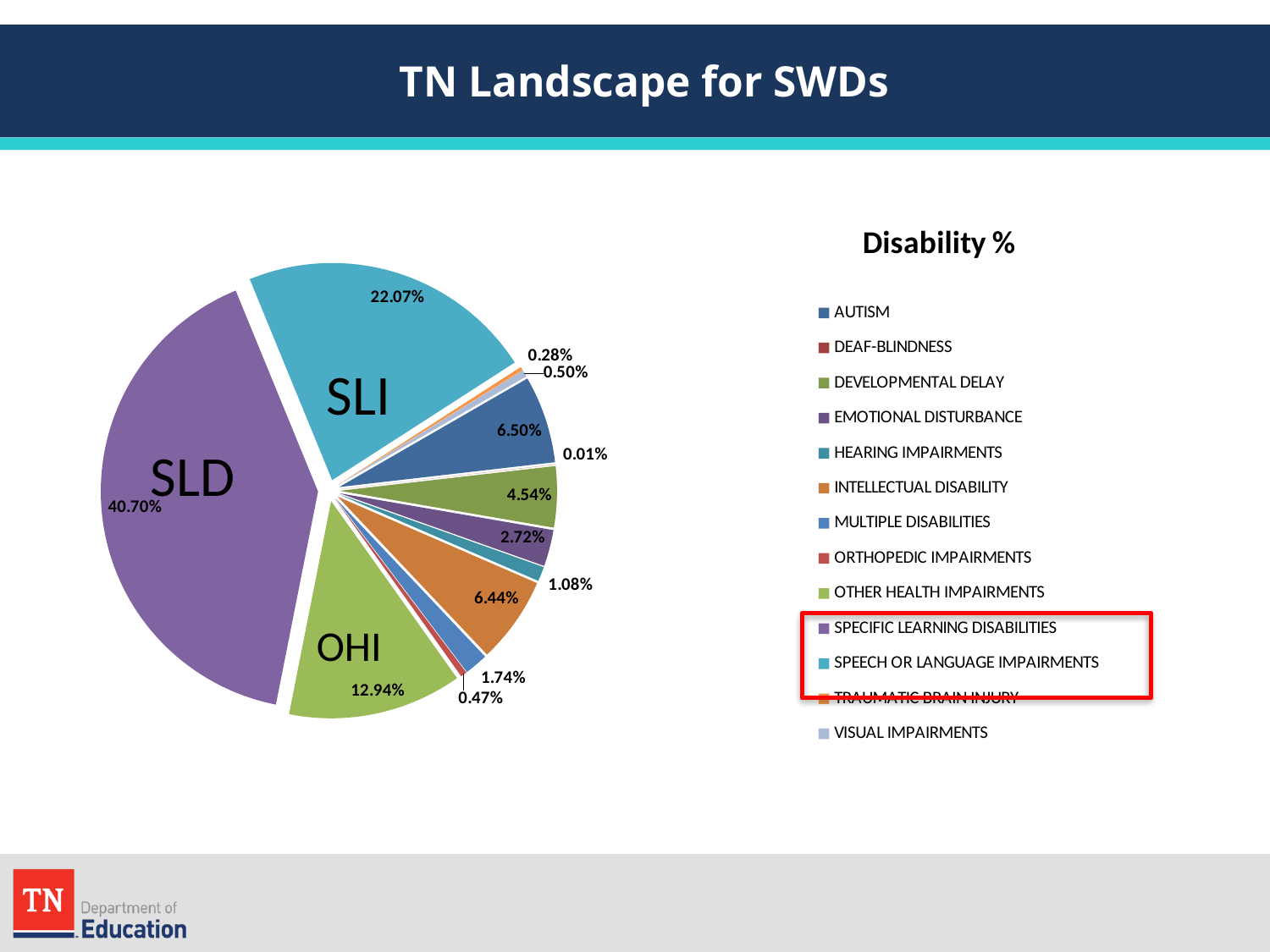
Which is larger, the SLI slice or the OHI slice? SLI Which slice of the pie chart is the largest? SLD What percentage is shown for the OHI slice? 12.94% What type of chart is shown on the slide? Pie chart What is the title of the chart? Disability % What percentage is shown for the SLI slice? 22.07% What is the difference between the SLI slice and the OHI slice? 9.13% What percentage is shown for the Intellectual Disability slice (orange)? 6.44% What percentage is shown for the Autism slice (dark blue)? 6.50% What is the difference between the SLD slice and the SLI slice? 18.63% What percentage is shown for the SLD slice? 40.70% How many categories are listed in the chart's legend? 13